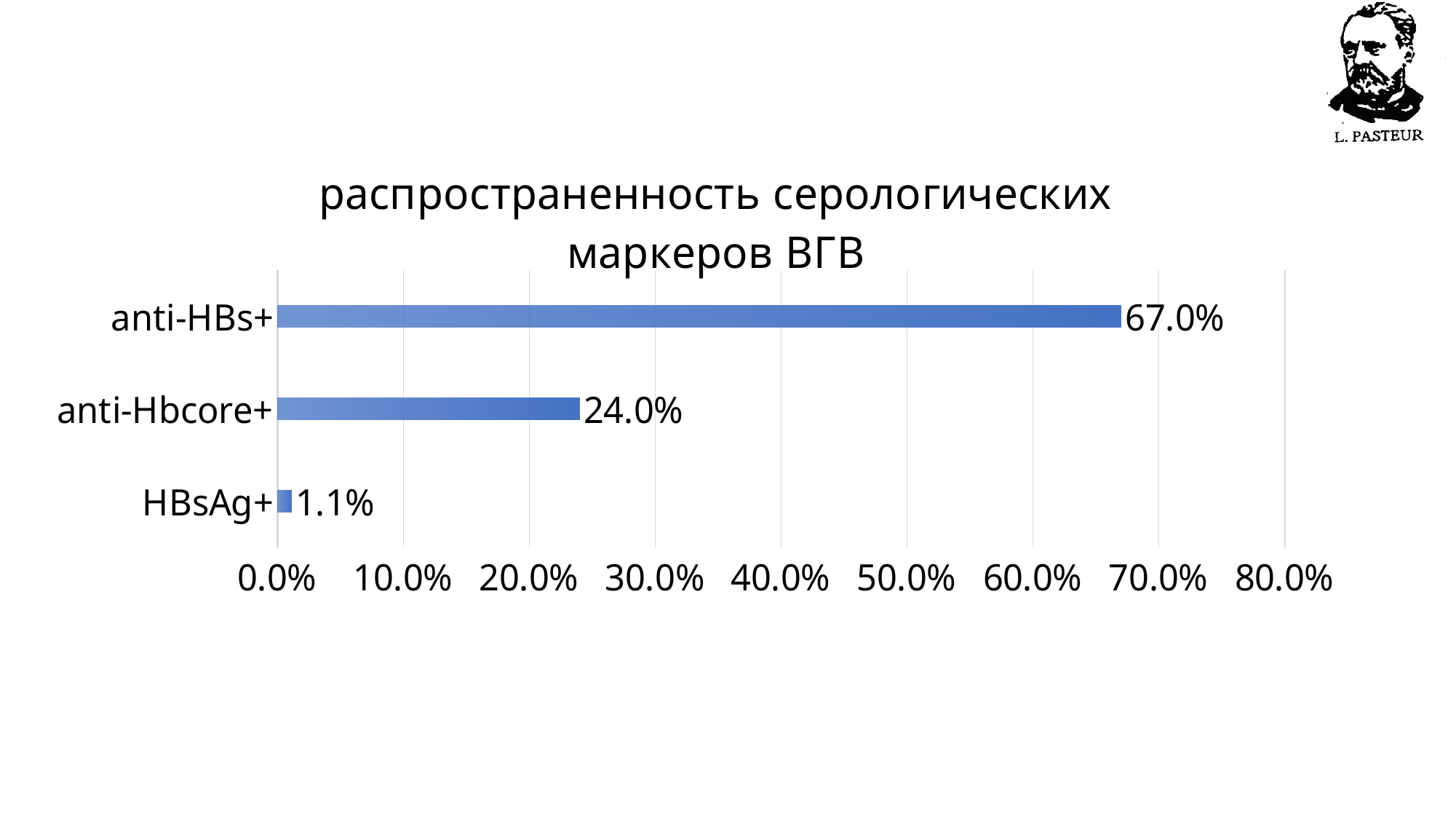
Is the value for anti-HBs+ greater or less than 60.0%? greater Which category has the lowest value? HBsAg+ What is the value for HBsAg+? 1.1% How many categories are shown in the chart? 3 What is the value for anti-Hbcore+? 24.0% What is the value for anti-HBs+? 67.0% What is the title of the chart? распространенность серологических маркеров ВГВ What is the difference between the values for anti-Hbcore+ and HBsAg+? 22.9% Which is larger, the value for anti-Hbcore+ or the value for HBsAg+? anti-Hbcore+ What is the difference between the values for anti-HBs+ and anti-Hbcore+? 43.0% Which category has the highest value? anti-HBs+ What kind of chart is shown on the slide? bar chart